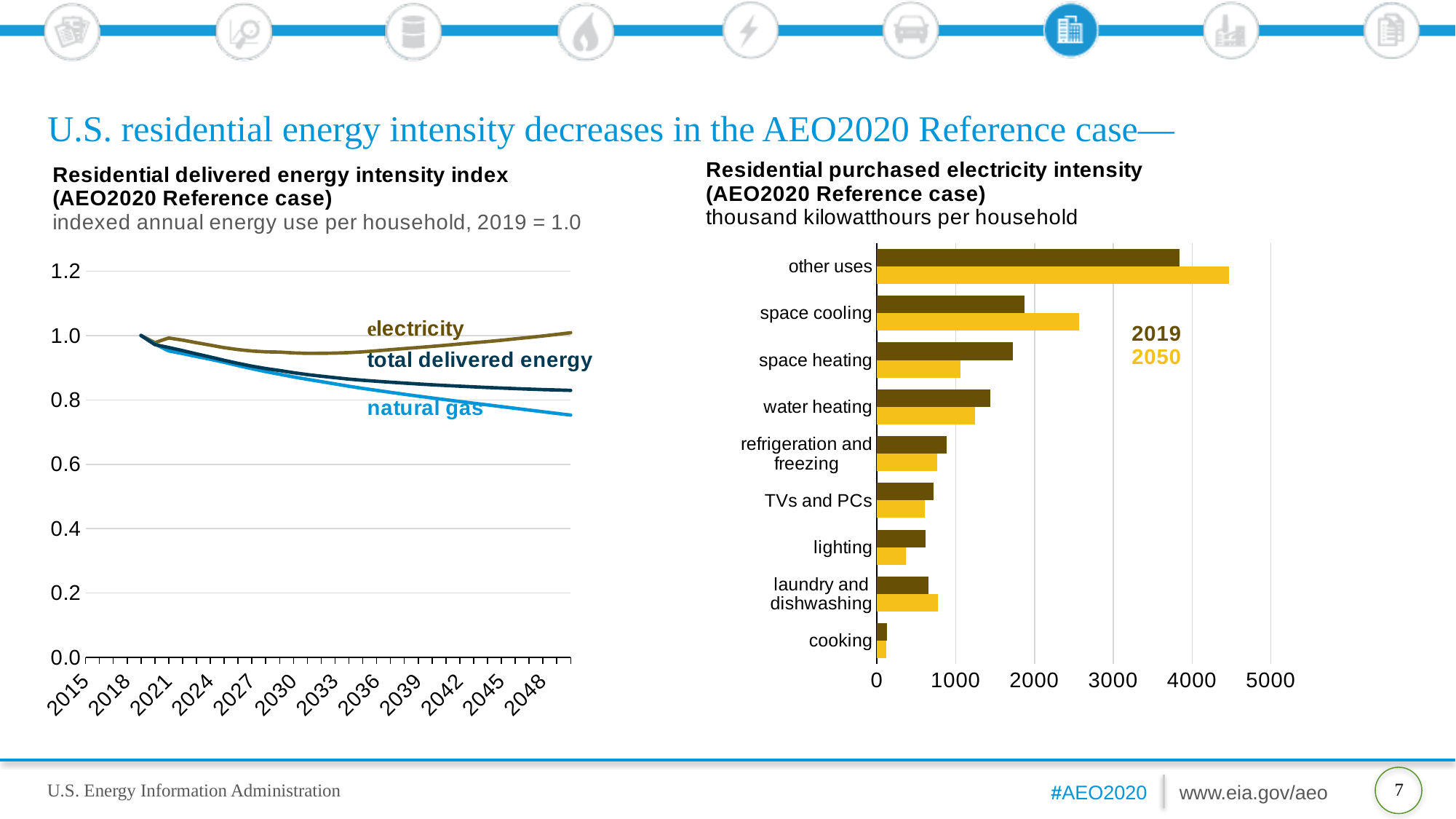
What kind of chart is the 'Residential delivered energy intensity index' chart on the left? line chart In the 'Residential purchased electricity intensity' chart, which is larger for lighting: the 2019 value or the 2050 value? 2019 What kind of chart is the 'Residential purchased electricity intensity' chart on the right? bar chart In the 'Residential purchased electricity intensity' chart, how many end-use categories are shown? 9 In the 'Residential purchased electricity intensity' chart, which is larger for space heating: the 2019 value or the 2050 value? 2019 In the 'Residential purchased electricity intensity' chart, is the 2050 value for space cooling greater or less than 2000? greater In the 'Residential purchased electricity intensity' chart, how many series does the legend list? 2 In the 'Residential purchased electricity intensity' chart, which category has the highest value in 2050? other uses In the 'Residential purchased electricity intensity' chart, is the 2050 value for other uses greater or less than 4000? greater In the 'Residential delivered energy intensity index' chart, does the natural gas line rise or fall from 2019 to 2050? fall In the 'Residential delivered energy intensity index' chart, which series is shown in the light blue line? natural gas In the 'Residential purchased electricity intensity' chart, which category has the lowest value in 2019? cooking